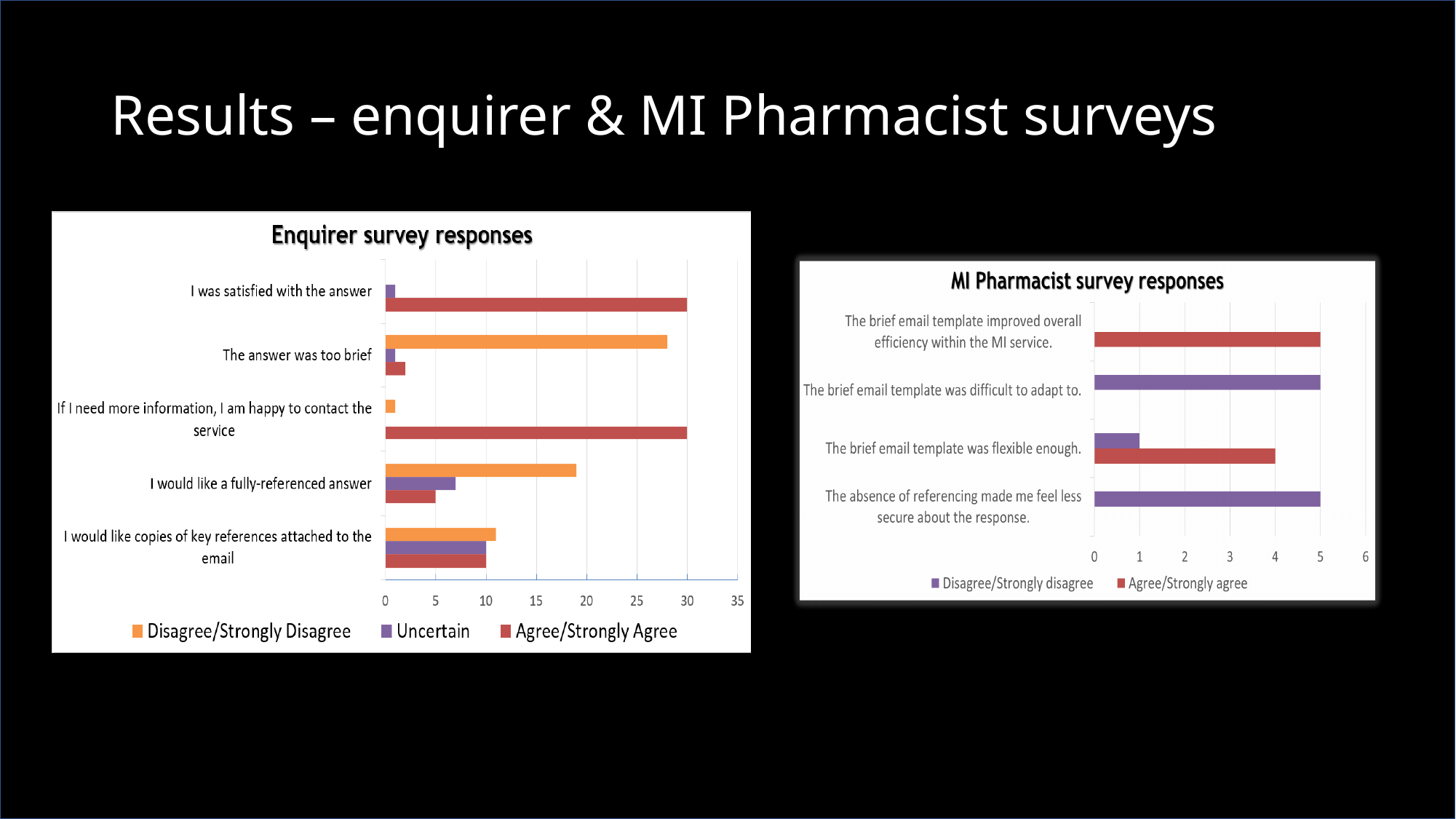
In the MI Pharmacist survey responses chart, what is the Disagree/Strongly disagree value for "The absence of referencing made me feel less secure about the response."? 5 In the Enquirer survey responses chart, which is larger for "I would like a fully-referenced answer": the Disagree/Strongly Disagree value or the Uncertain value? Disagree/Strongly Disagree In the Enquirer survey responses chart, how many statements (categories) are shown? 5 In the MI Pharmacist survey responses chart, how many statements (categories) are shown? 4 In the MI Pharmacist survey responses chart, what is the Disagree/Strongly disagree value for "The brief email template was flexible enough."? 1 In the MI Pharmacist survey responses chart, how many series does the legend list? 2 In the Enquirer survey responses chart, is the Agree/Strongly Agree value for "I would like a fully-referenced answer" greater or less than 10? less In the Enquirer survey responses chart, is the Disagree/Strongly Disagree value for "The answer was too brief" greater or less than 25? greater In the MI Pharmacist survey responses chart, what is the Agree/Strongly agree value for "The brief email template was flexible enough."? 4 In the Enquirer survey responses chart, how many series does the legend list? 3 In the MI Pharmacist survey responses chart, what is the Agree/Strongly agree value for "The brief email template improved overall efficiency within the MI service."? 5 What kind of chart is the Enquirer survey responses chart? Bar chart